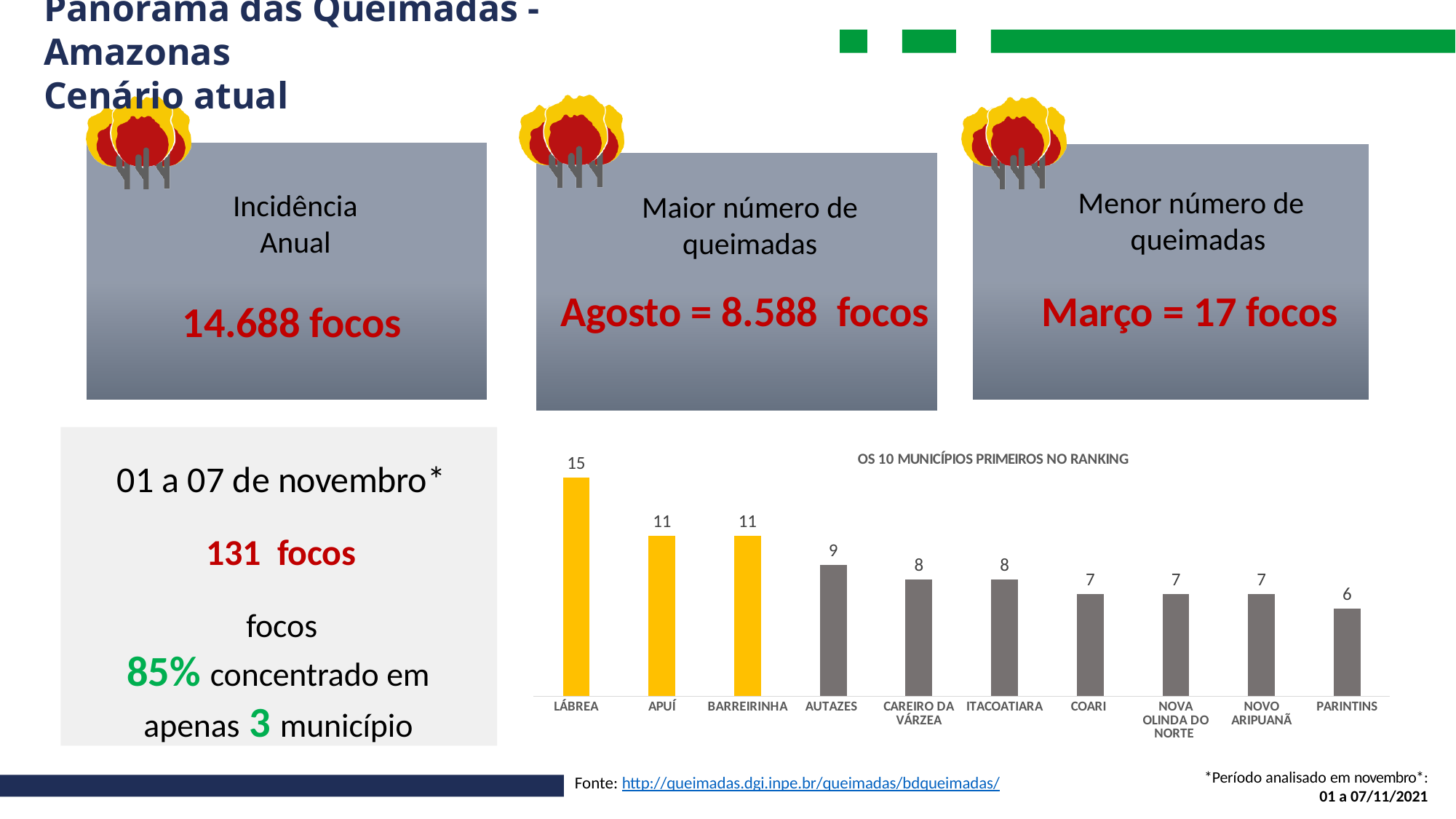
What is the value for LÁBREA? 15 What is the difference between the values for AUTAZES and PARINTINS? 3 Which is larger, the value for BARREIRINHA or the value for ITACOATIARA? BARREIRINHA What is the value for AUTAZES? 9 What is the difference between the values for LÁBREA and APUÍ? 4 Which municipality has the highest value in the chart? LÁBREA What is the title of the chart? OS 10 MUNICÍPIOS PRIMEIROS NO RANKING What is the value for PARINTINS? 6 Which municipality has the lowest value in the chart? PARINTINS What kind of chart is shown on the slide? Bar chart How many municipalities are shown in the chart? 10 What is the value for COARI? 7